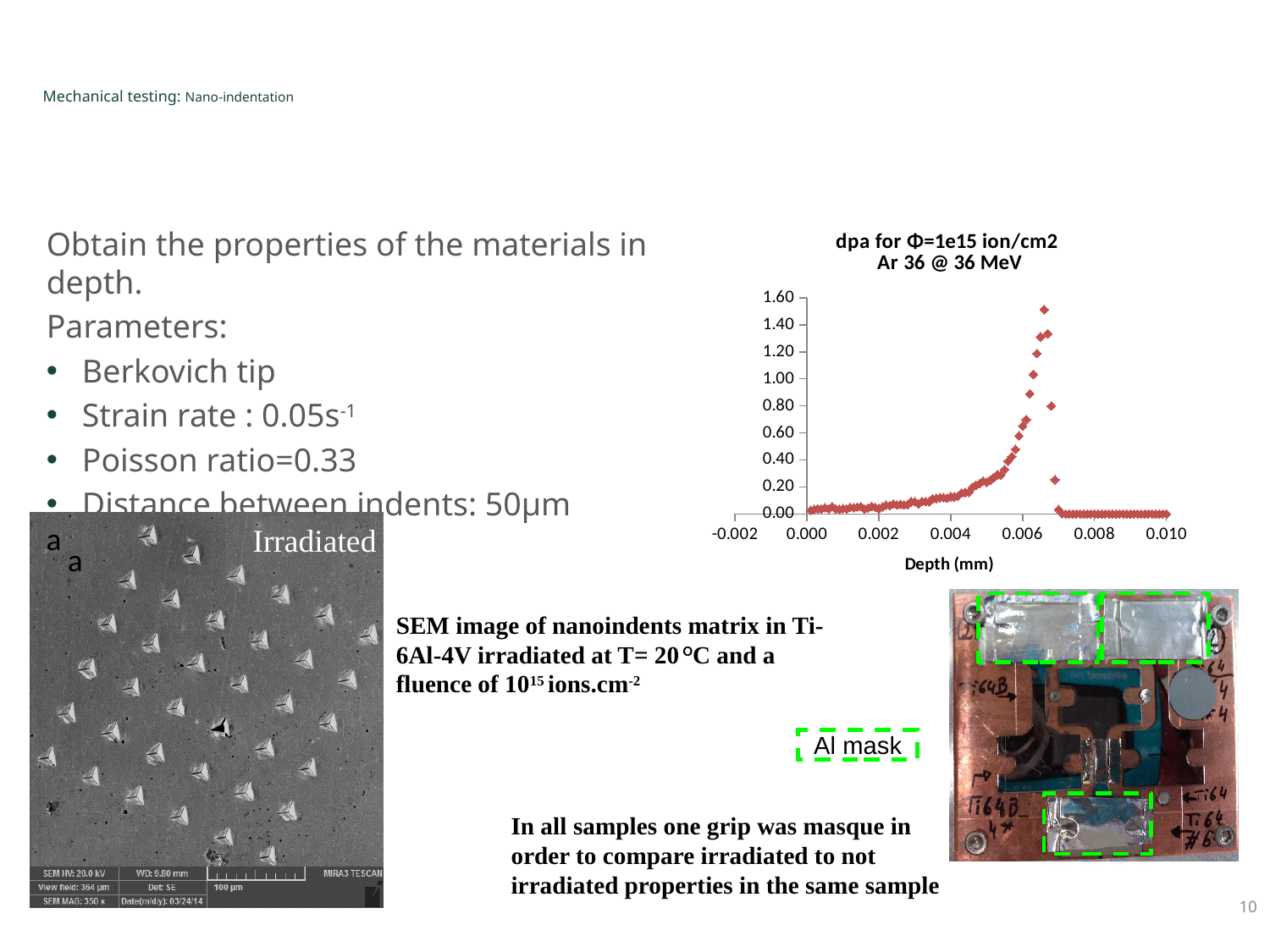
Is the highest plotted value on the chart greater or less than 1.40? greater How do the plotted values change as depth increases from about 0.0065 mm to 0.010 mm? they fall Is the plotted value at a depth of 0.008 mm greater or less than 0.20? less How do the plotted values change as depth increases from 0.000 mm to about 0.0065 mm? they rise What is the label of the x axis of the chart? Depth (mm) What kind of chart is shown on the slide? scatter chart Is the plotted value at a depth of 0.002 mm greater or less than 0.20? less What is the title of the chart on the slide? dpa for Φ=1e15 ion/cm2 Ar 36 @ 36 MeV What is the highest tick value shown on the y axis of the chart? 1.60